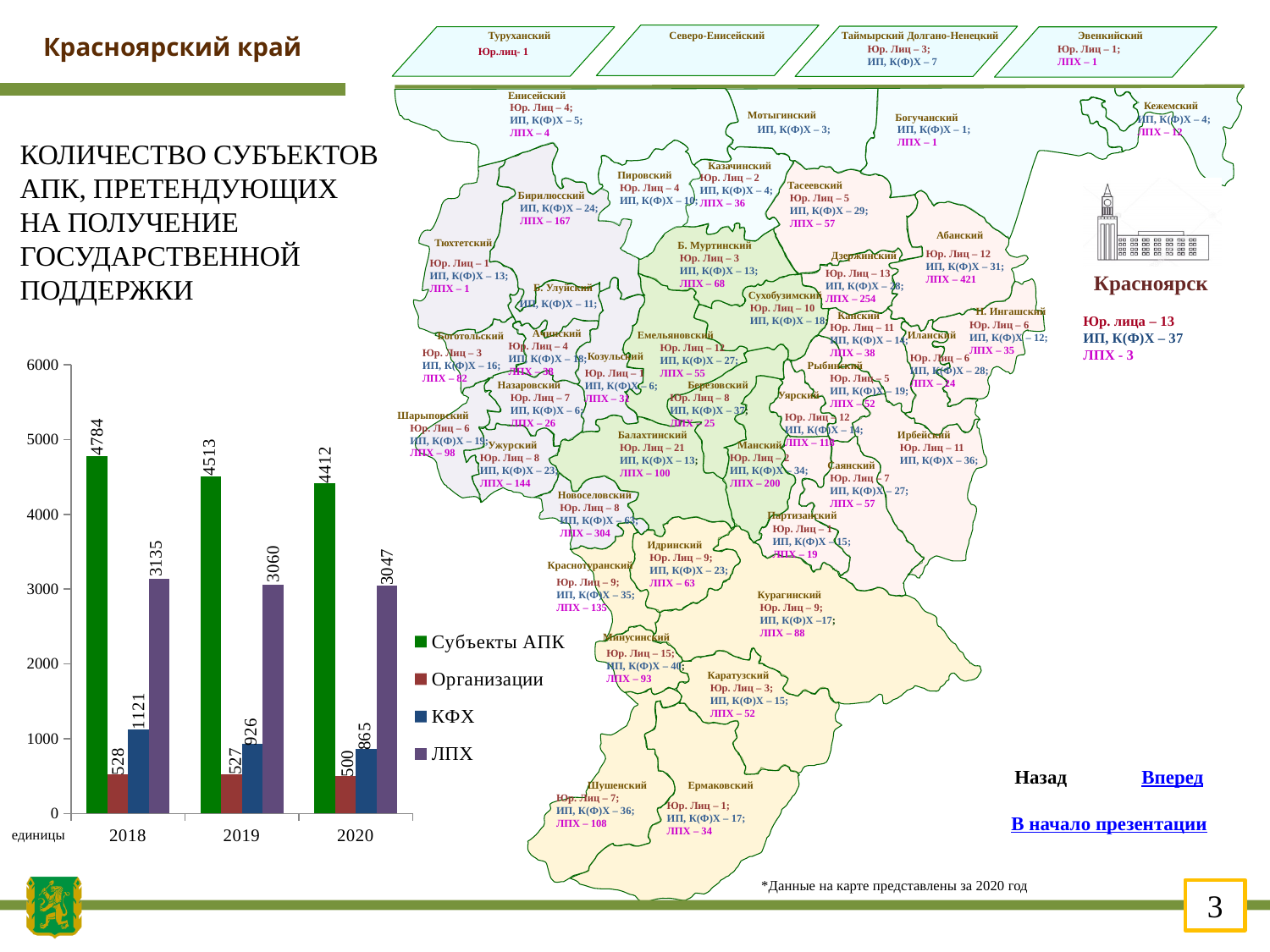
In which year is the value for КФХ the lowest? 2020 What is the value for Субъекты АПК in 2018? 4784 What is the value for ЛПХ in 2020? 3047 What is the value for КФХ in 2019? 926 What is the difference between the Субъекты АПК values for 2018 and 2020? 372 How many years are shown on the x axis of the bar chart? 3 Does the value for Субъекты АПК rise or fall from 2018 to 2020? fall What is the value for Организации in 2020? 500 In which year is the value for Субъекты АПК the highest? 2018 Which is larger: КФХ in 2018 or КФХ in 2019? КФХ in 2018 How many series does the legend of the bar chart list? 4 What kind of chart is shown on the left of the slide? bar chart